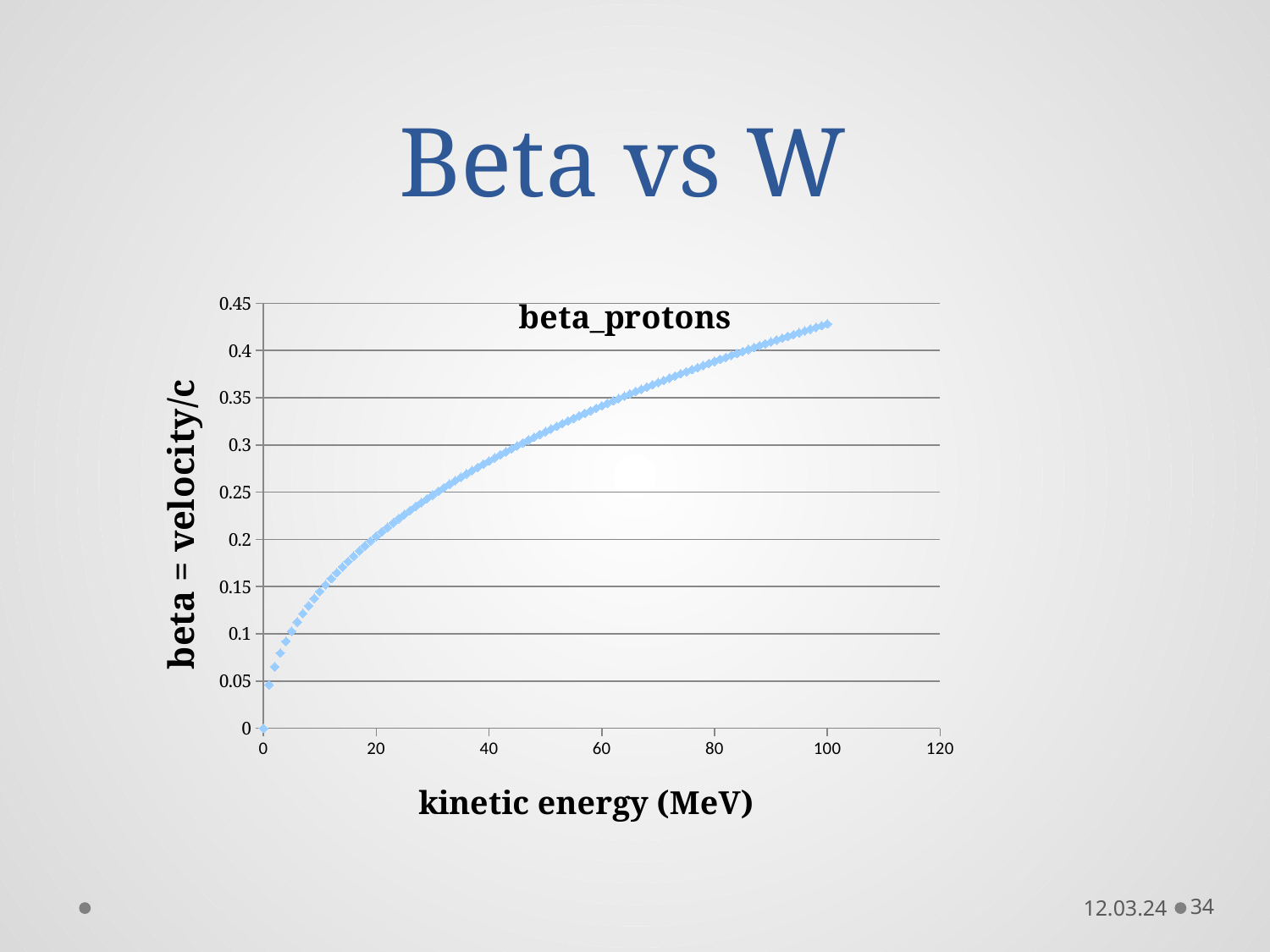
Is the value of beta at 80 MeV greater or less than 0.4? less Is the value of beta at 40 MeV greater or less than 0.3? less Is the value of beta at 30 MeV greater or less than 0.2? greater What kind of chart is shown on the slide? scatter chart What is the label of the x axis? kinetic energy (MeV) Does beta rise or fall as kinetic energy increases along the x axis? rise What is the title of the chart? beta_protons At which kinetic energy does the plotted series reach its highest beta value? 100